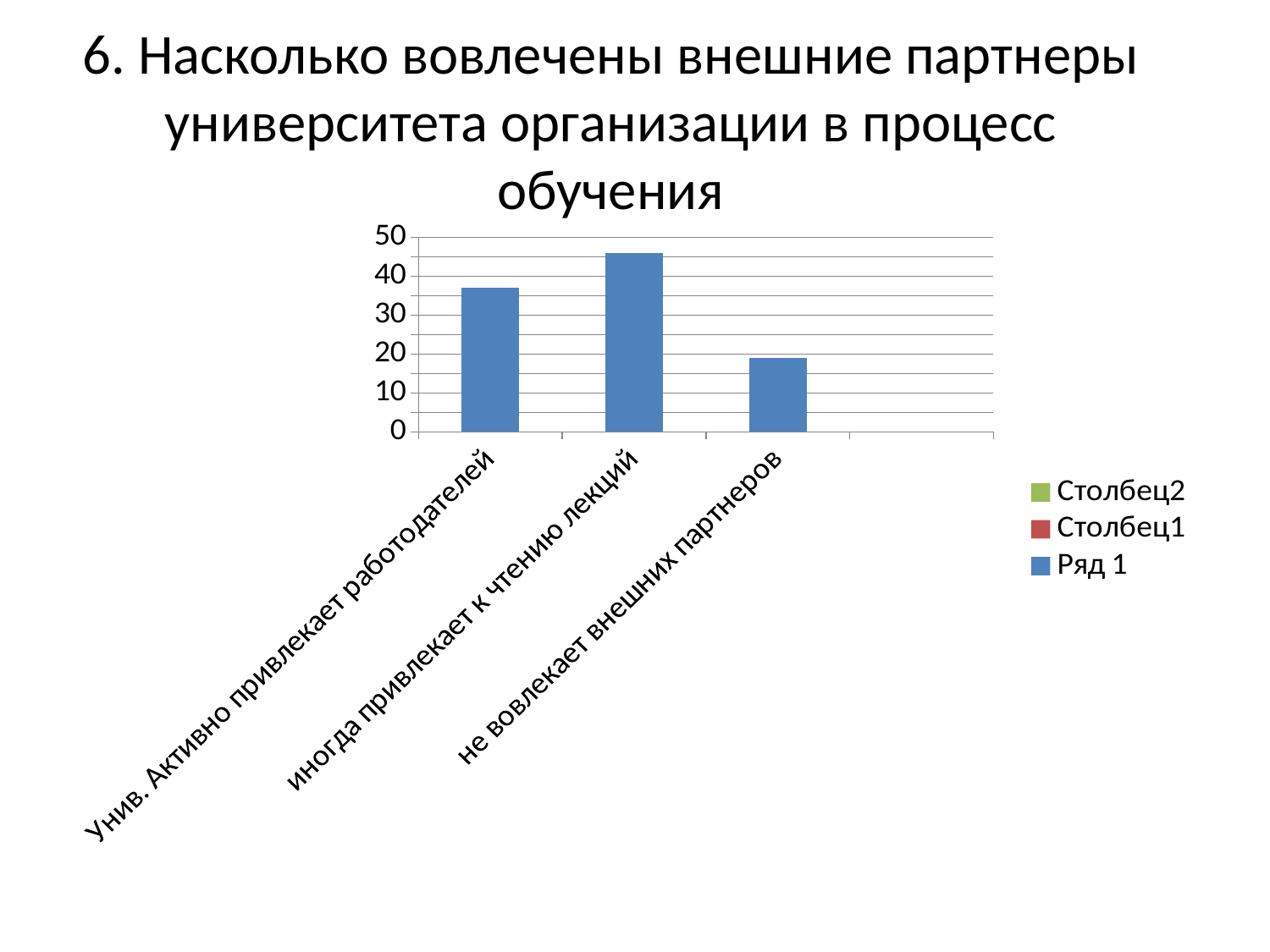
Which is larger: the value for "иногда привлекает к чтению лекций" or the value for "Унив. Активно привлекает работодателей"? иногда привлекает к чтению лекций Which category has the highest bar? иногда привлекает к чтению лекций What is the maximum value shown on the vertical axis of the chart? 50 How many categories are shown on the x axis of the chart? 3 Which is larger: the value for "Унив. Активно привлекает работодателей" or the value for "не вовлекает внешних партнеров"? Унив. Активно привлекает работодателей Is the value for "иногда привлекает к чтению лекций" greater or less than 40? greater What is the name of the series that is plotted in blue in the chart? Ряд 1 Which category has the lowest bar? не вовлекает внешних партнеров Is the value for "Унив. Активно привлекает работодателей" greater or less than 30? greater What kind of chart is shown on the slide? bar chart How many series does the chart legend list? 3